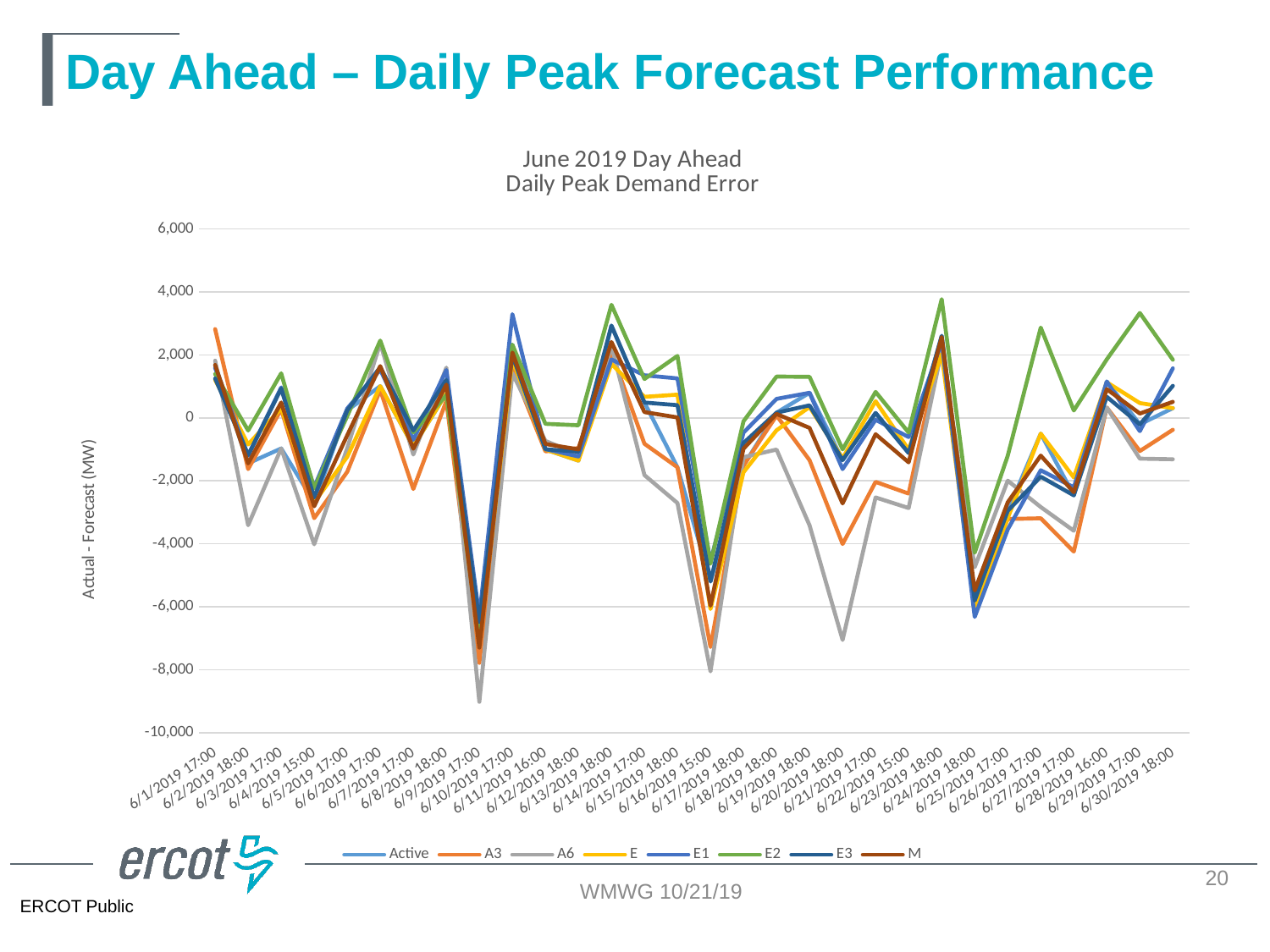
What is the title of the chart? June 2019 Day Ahead Daily Peak Demand Error How many dates are plotted along the x axis? 30 Is the value for E2 on 6/24/2019 18:00 greater or less than 2,000? less What is the label on the vertical axis? Actual - Forecast (MW) Is the value for E2 on 6/27/2019 17:00 greater or less than 2,000? less Is the value for A6 on 6/10/2019 17:00 greater or less than -8,000? greater On which date does the A6 series reach its lowest value? 6/9/2019 17:00 How many series does the legend list? 8 What kind of chart is shown on the slide? line chart